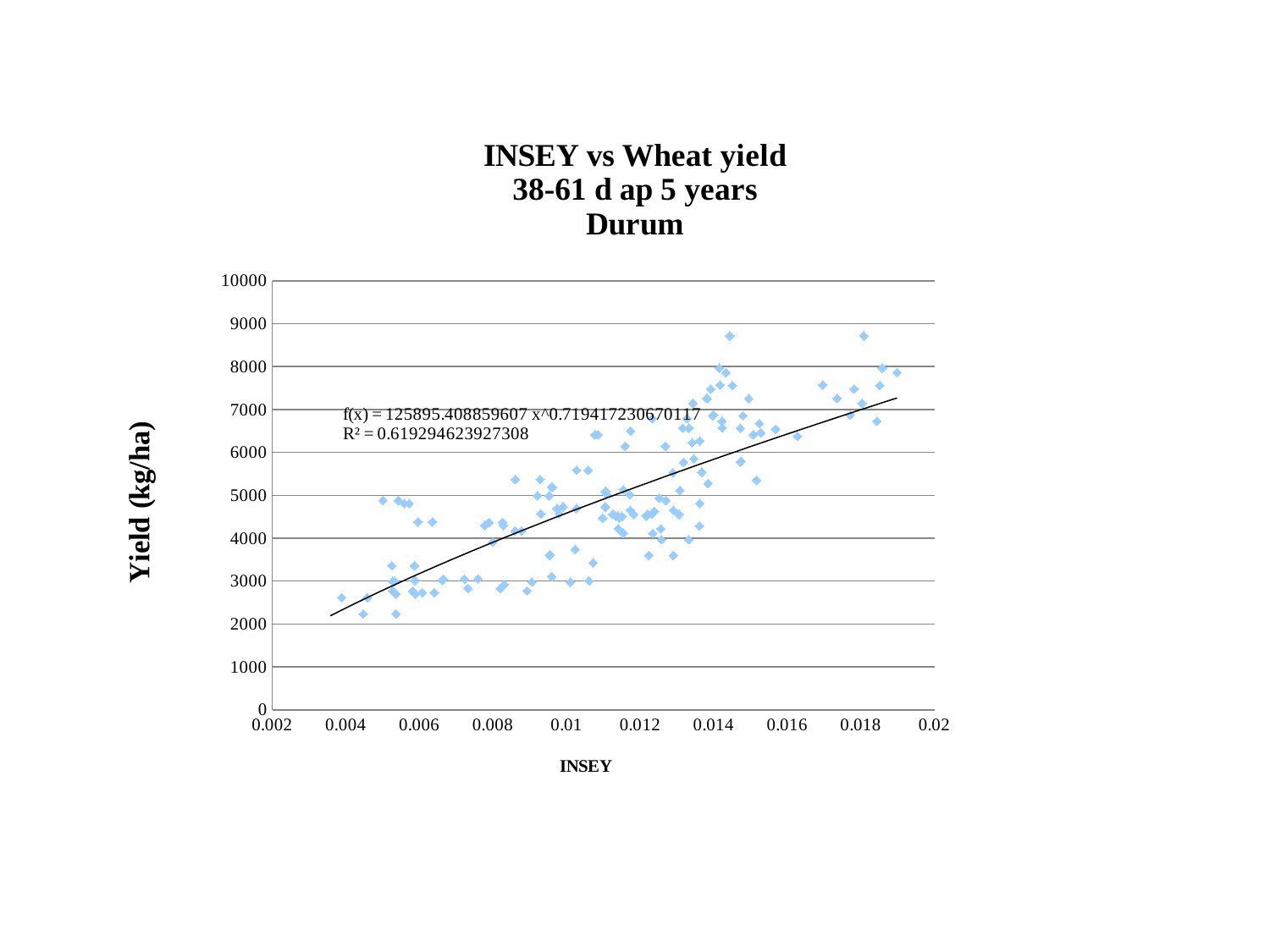
Is the lowest plotted yield value greater or less than 3000? less What is the maximum value shown on the x axis? 0.02 Do the plotted yield values generally rise or fall as INSEY increases along the x axis? rise What is the title of the chart? INSEY vs Wheat yield 38-61 d ap 5 years Durum What is the minimum value shown on the x axis? 0.002 What fitted equation is printed on the chart? f(x) = 125895.408859607 x^0.719417230670117 Is the highest plotted yield value greater or less than 8000? greater What is the label of the y axis? Yield (kg/ha) What kind of chart is shown on the slide? scatter chart What R² value is printed on the chart? 0.619294623927308 What is the maximum value shown on the y axis? 10000